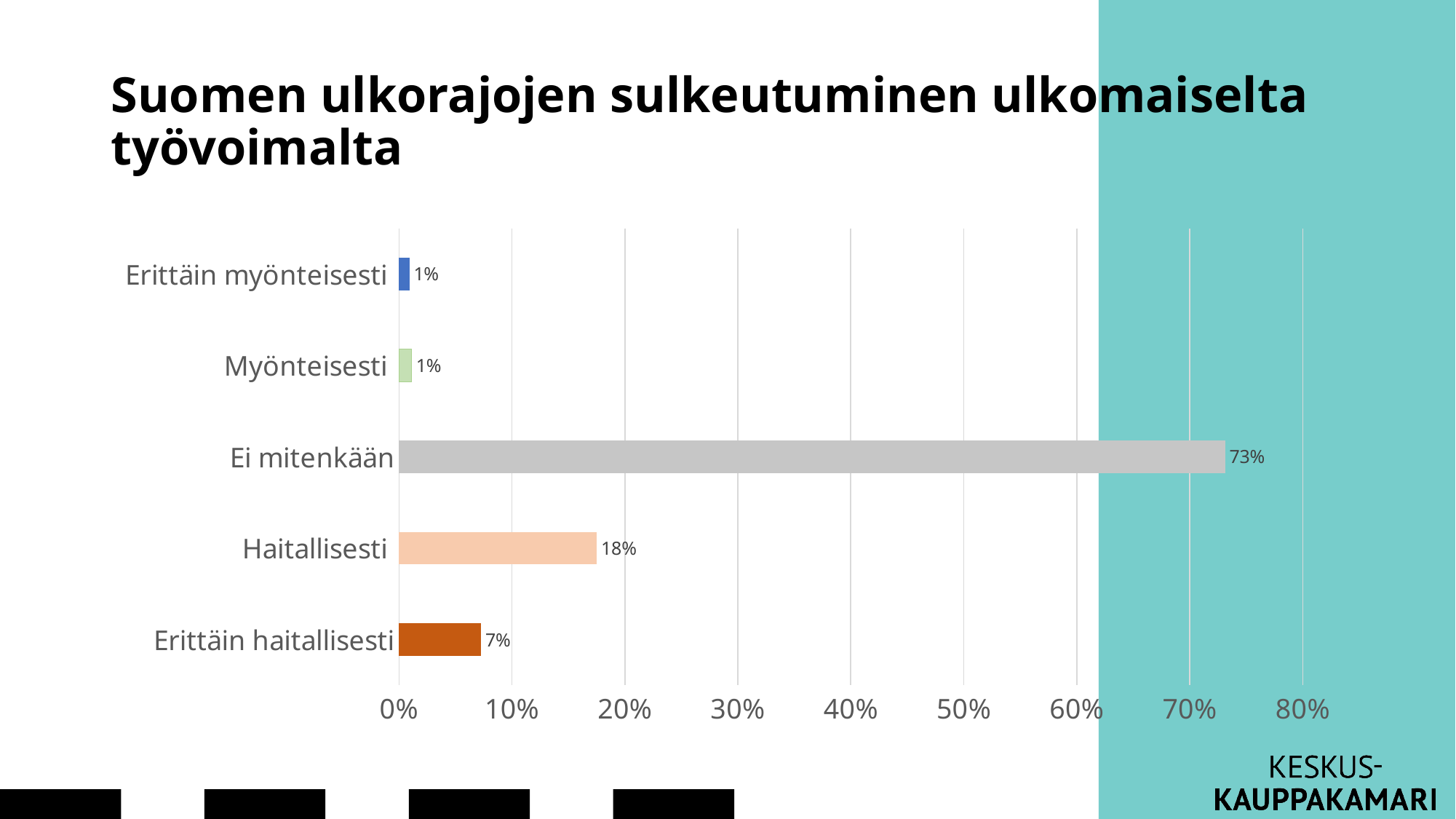
Is the value for Ei mitenkään greater or less than 70%? greater Which category has the highest value? Ei mitenkään What is the value for Ei mitenkään? 73% Which is larger, the value for Haitallisesti or the value for Erittäin haitallisesti? Haitallisesti What is the title of the slide? Suomen ulkorajojen sulkeutuminen ulkomaiselta työvoimalta What is the value for Myönteisesti? 1% What kind of chart is shown on the slide? Bar chart How many categories are shown in the chart? 5 What is the value for Haitallisesti? 18% What is the difference between the values for Ei mitenkään and Haitallisesti? 55% What is the difference between the values for Haitallisesti and Erittäin haitallisesti? 11% What is the value for Erittäin haitallisesti? 7%